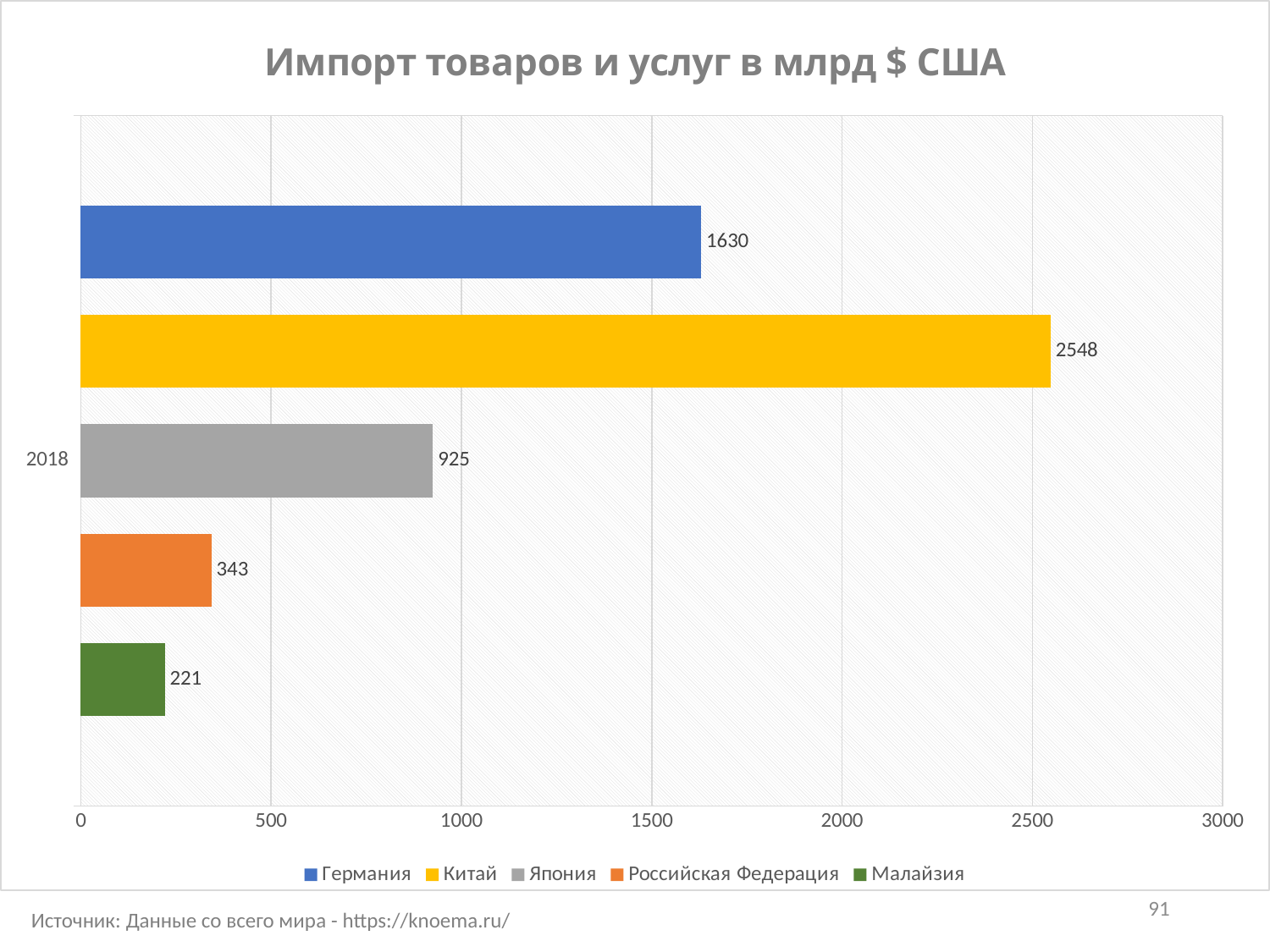
Which country has the highest import value in the chart? Китай What is the value for Япония (Japan) in the chart? 925 Which is larger, the value for Япония or the value for Российская Федерация? Япония Which country has the lowest import value in the chart? Малайзия How many series does the legend list? 5 What year is shown as the category label on the vertical axis? 2018 What is the difference between the values for Китай and Германия? 918 What is the value for Китай (China) in the chart? 2548 What is the value for Российская Федерация (Russian Federation) in the chart? 343 What kind of chart is shown on the slide? Bar chart What is the value for Германия (Germany) in the chart? 1630 Is the value for Германия greater or less than 1500? greater